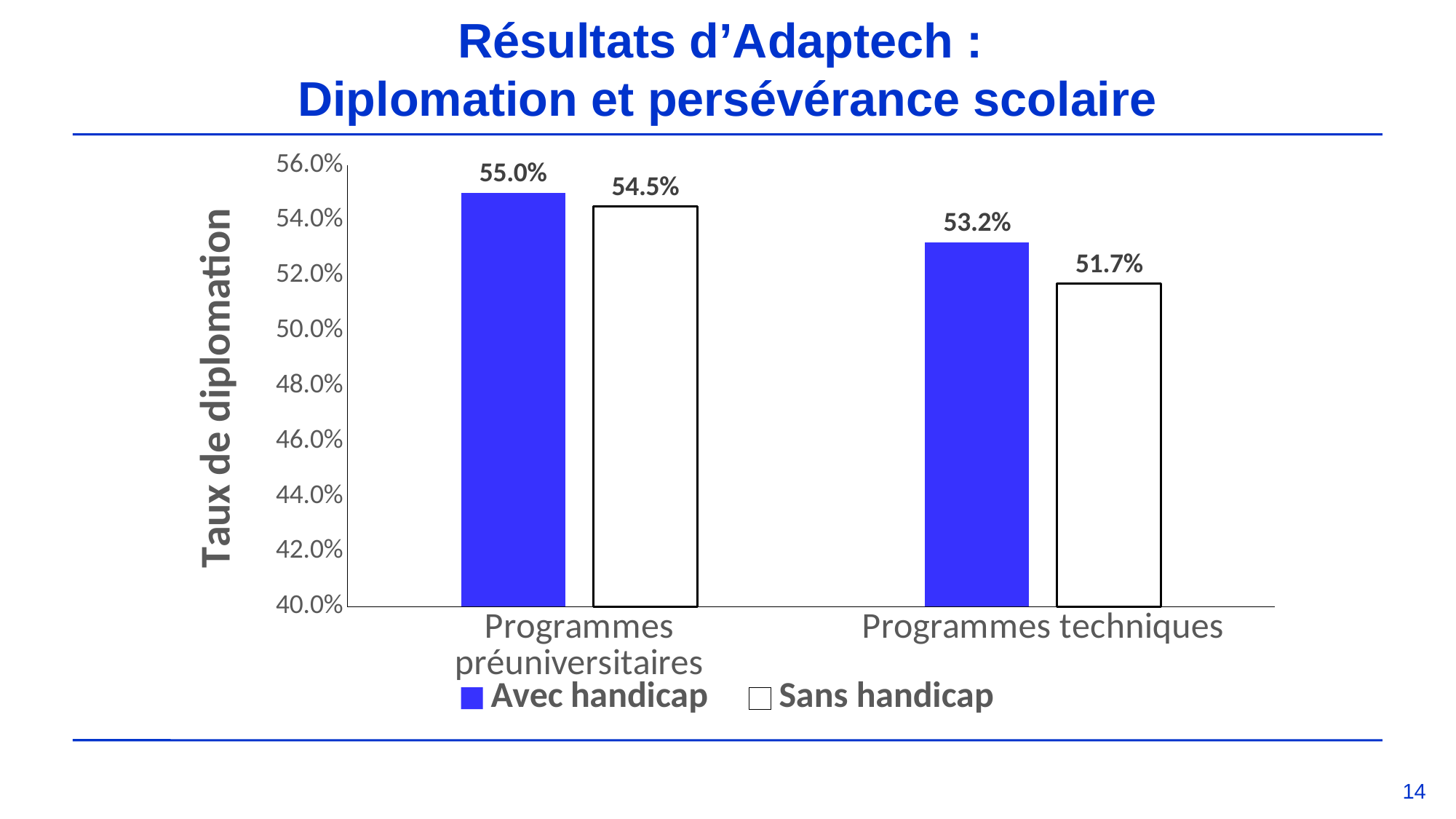
Which bar has the lowest diplomation rate on the chart? Sans handicap, Programmes techniques (51.7%) How many program categories are shown on the x axis? 2 What kind of chart is shown on the slide? Bar chart How many series does the legend list? 2 Which bar has the highest diplomation rate on the chart? Avec handicap, Programmes préuniversitaires (55.0%) Is the 'Sans handicap' value for Programmes techniques greater or less than 52.0%? less What is the difference between the 'Avec handicap' and 'Sans handicap' rates in Programmes techniques? 1.5% What is the diplomation rate for 'Sans handicap' in Programmes préuniversitaires? 54.5% What is the diplomation rate for 'Avec handicap' in Programmes techniques? 53.2% What is the diplomation rate for 'Sans handicap' in Programmes techniques? 51.7% What is the diplomation rate for 'Avec handicap' in Programmes préuniversitaires? 55.0% In Programmes préuniversitaires, which is larger: the 'Avec handicap' rate or the 'Sans handicap' rate? Avec handicap